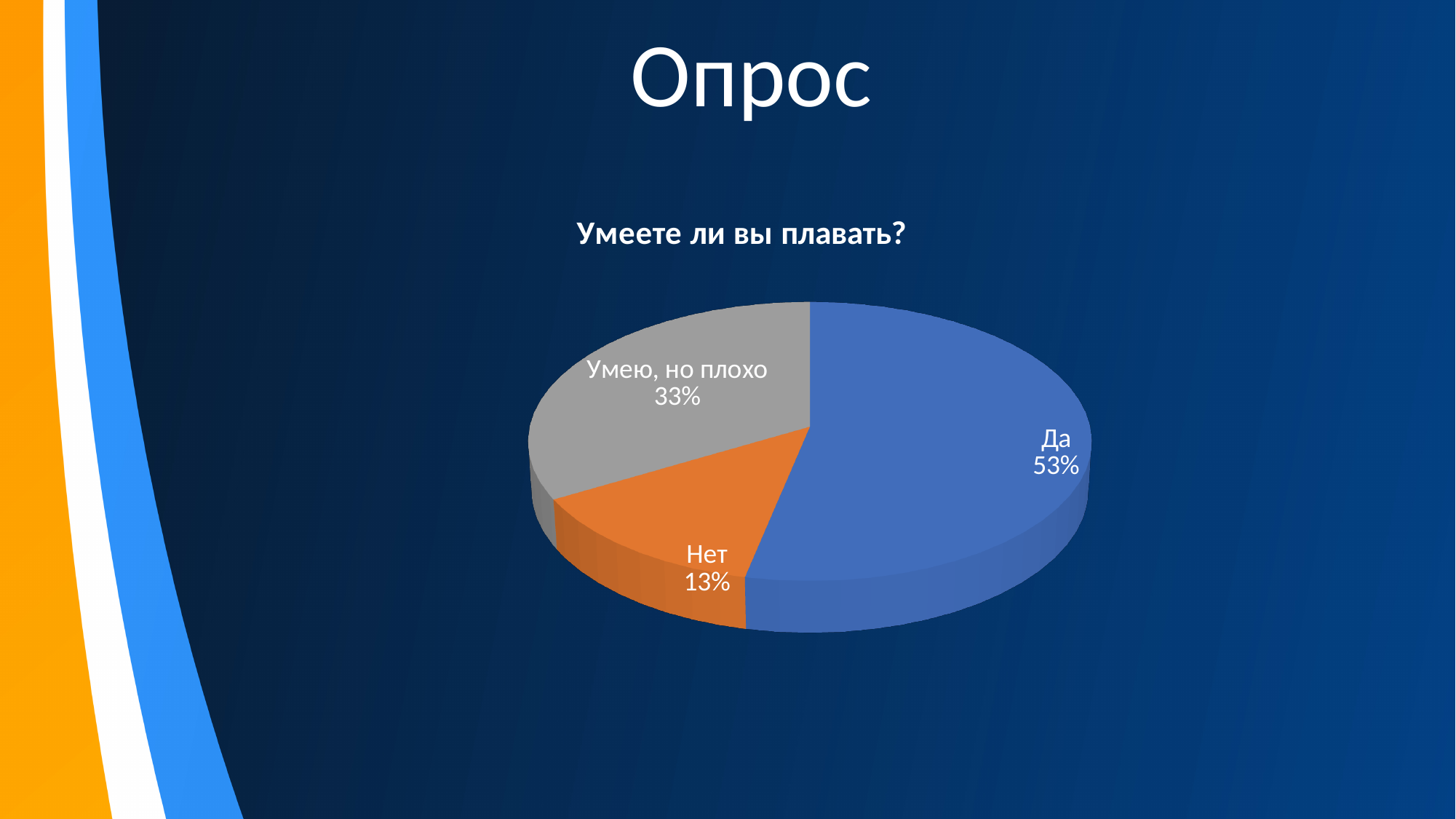
Which category has the largest slice of the pie? Да What is the difference in percentage points between the "Умею, но плохо" and "Нет" slices? 20 How many slices does the pie chart have? 3 Which slice is larger, "Умею, но плохо" or "Нет"? Умею, но плохо What share of the pie does the "Нет" slice represent? 13% What colour is the "Нет" slice? orange What kind of chart is shown on the slide? pie chart What share of the pie does the "Умею, но плохо" slice represent? 33% What share of the pie does the "Да" slice represent? 53% What is the title of the chart? Умеете ли вы плавать? What is the difference in percentage points between the "Да" and "Нет" slices? 40 Which category has the smallest slice of the pie? Нет